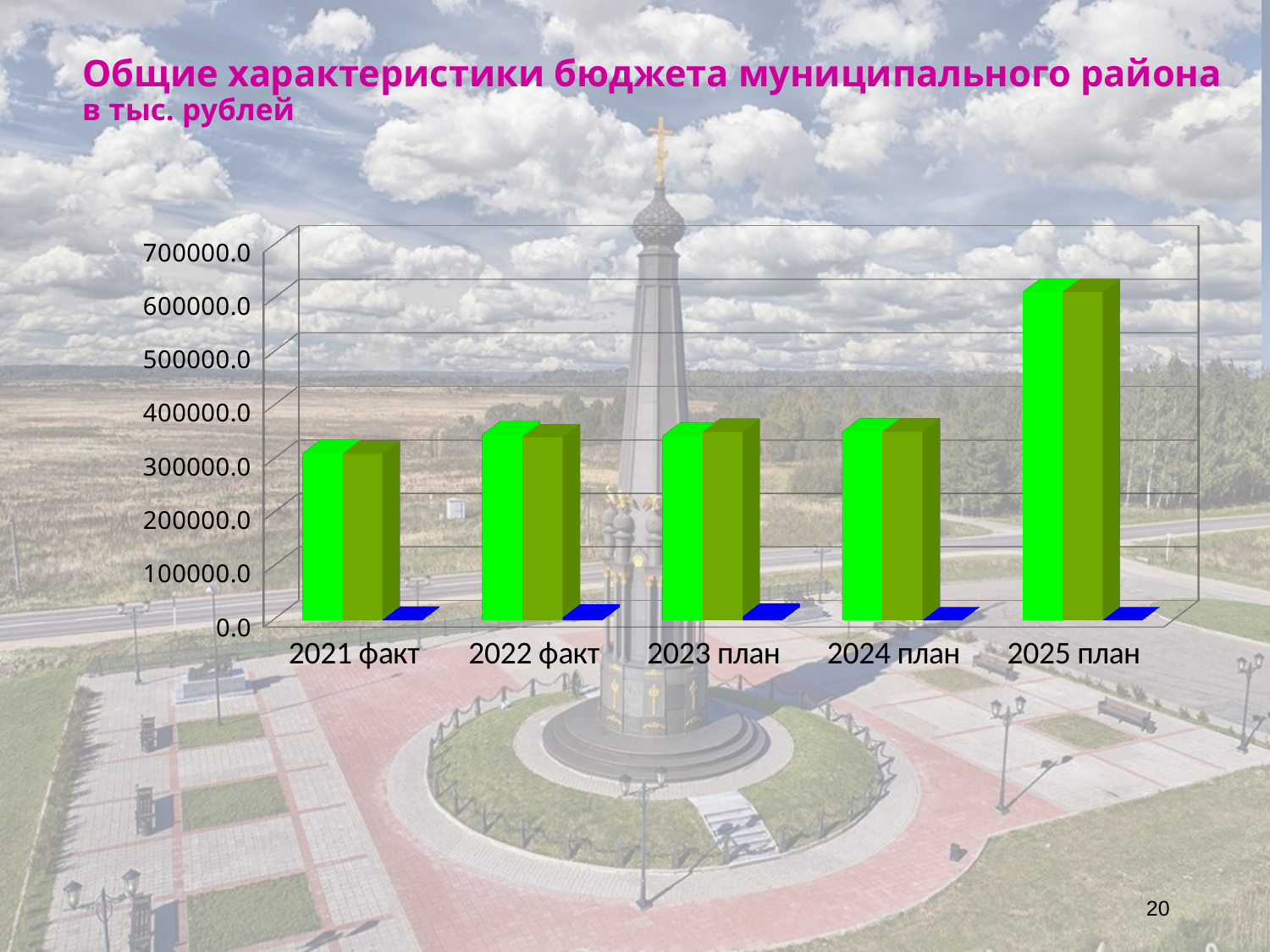
Is the green bar value for 2021 факт greater or less than 300000.0? greater How many categories are shown on the x axis of the chart? 5 Which category has the lowest green bar in the chart? 2021 факт What is the title of the slide containing the chart? Общие характеристики бюджета муниципального района What kind of chart is shown on the slide? bar chart What is the highest tick value shown on the y axis of the chart? 700000.0 Is the green bar value for 2024 план greater or less than 400000.0? less Is the green bar value for 2025 план greater or less than 600000.0? greater Which category has the highest green bar in the chart? 2025 план Which is larger, the green bar for 2025 план or the green bar for 2022 факт? 2025 план